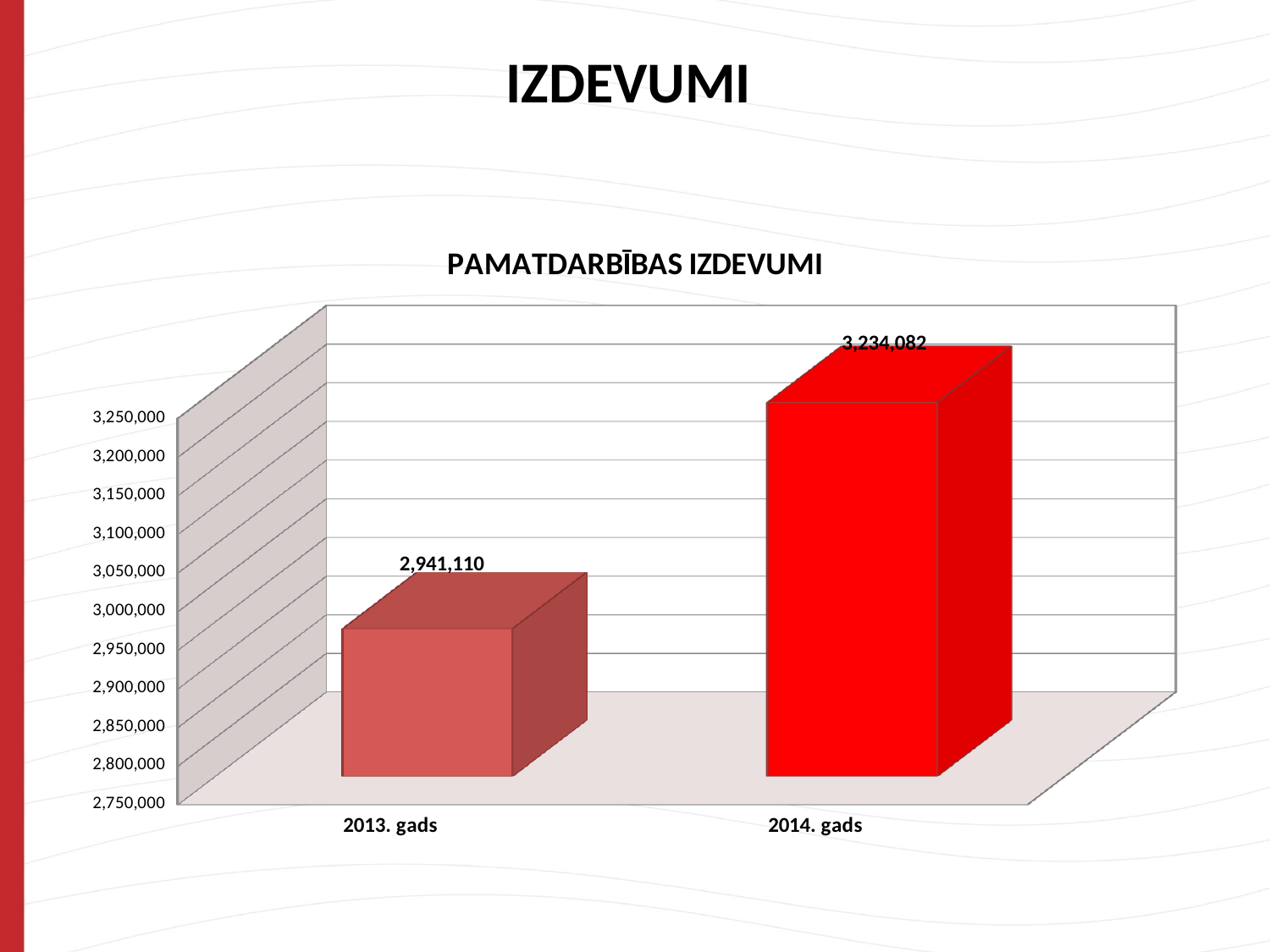
What is the difference between the values for 2014. gads and 2013. gads? 292,972 Which year has the lowest value? 2013. gads How many categories are shown on the chart? 2 Is the value for 2014. gads greater or less than 3,200,000? greater Is the value for 2013. gads greater or less than 3,000,000? less What is the title of the chart? PAMATDARBĪBAS IZDEVUMI Do the values rise or fall from 2013. gads to 2014. gads? rise Which year has the highest value? 2014. gads What is the value for 2013. gads? 2,941,110 Which is larger, the value for 2013. gads or the value for 2014. gads? 2014. gads What is the value for 2014. gads? 3,234,082 What kind of chart is shown on the slide? bar chart